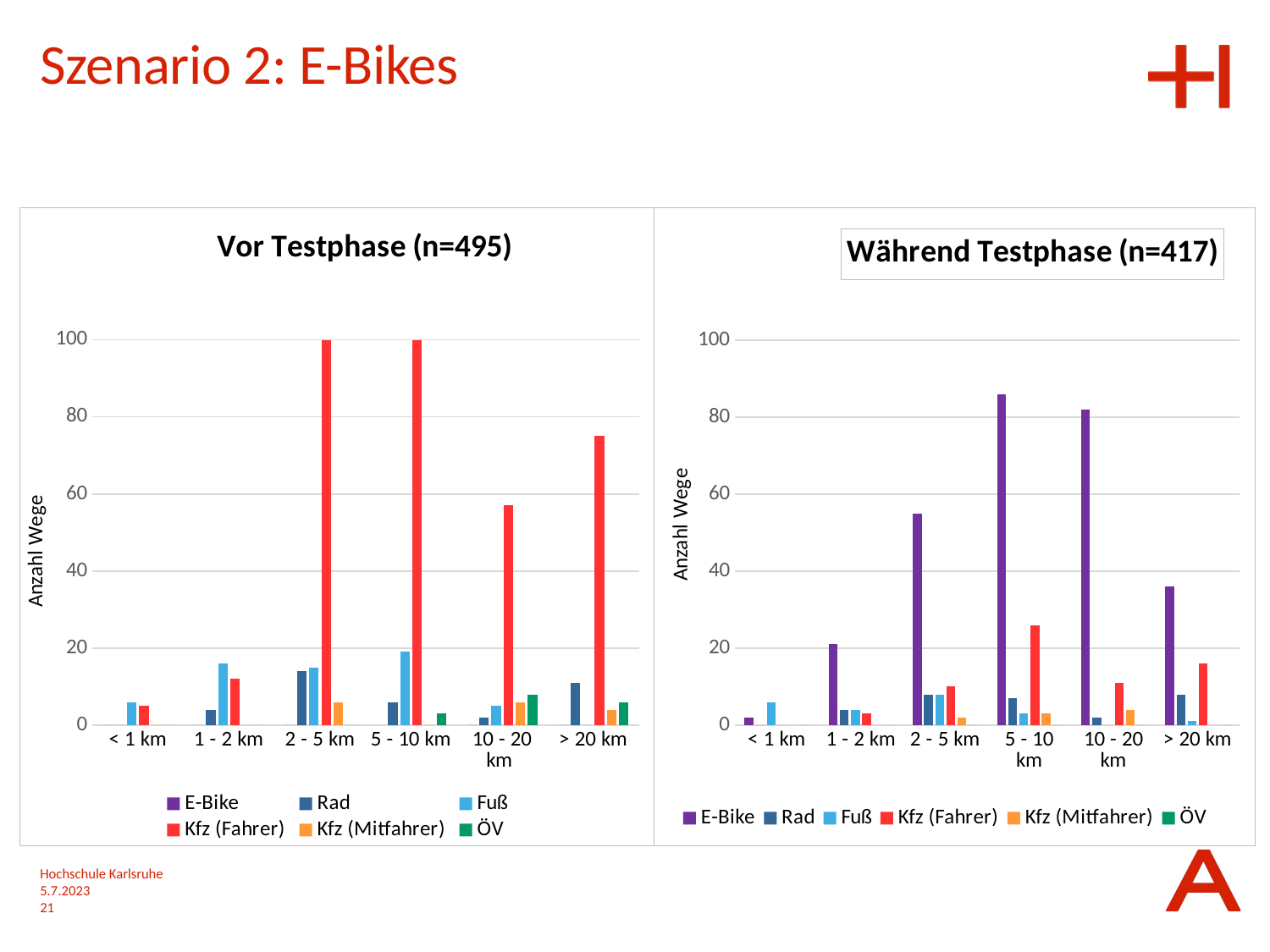
In the "Vor Testphase (n=495)" chart, is the Kfz (Fahrer) value for 10 - 20 km greater or less than 40? greater What colour represents the E-Bike series in the "Während Testphase (n=417)" chart? purple In the "Vor Testphase (n=495)" chart, which is larger for 1 - 2 km: Fuß or Rad? Fuß What kind of chart is the "Vor Testphase (n=495)" chart? bar chart In the "Während Testphase (n=417)" chart, is the E-Bike value for 2 - 5 km greater or less than 40? greater In the "Vor Testphase (n=495)" chart, is the Kfz (Fahrer) value for > 20 km greater or less than 60? greater In the "Während Testphase (n=417)" chart, which series has the highest value in the 5 - 10 km category? E-Bike How many distance categories are shown on the x axis of the "Vor Testphase (n=495)" chart? 6 In the "Während Testphase (n=417)" chart, which is larger for 5 - 10 km: E-Bike or Kfz (Fahrer)? E-Bike What is the title of the chart on the right side of the slide? Während Testphase (n=417) In the "Während Testphase (n=417)" chart, which distance category has the lowest E-Bike value? < 1 km How many series does the legend of the "Während Testphase (n=417)" chart list? 6